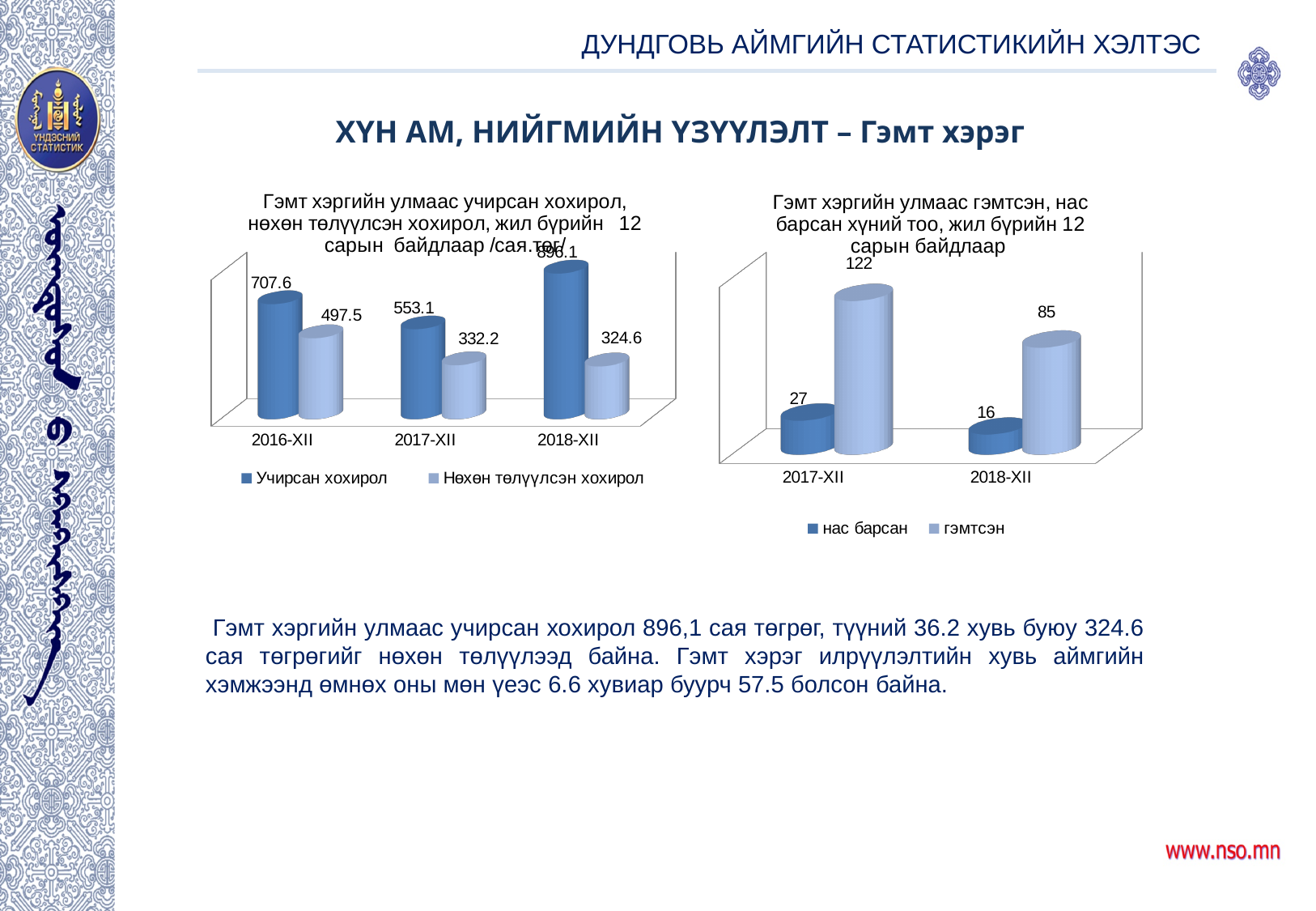
On the left chart, what is the value of Нөхөн төлүүлсэн хохирол for 2017-XII? 332.2 On the left chart, how many year categories are shown on the x axis? 3 On the left chart, how many series does the legend list? 2 On the left chart, what is the difference between Учирсан хохирол and Нөхөн төлүүлсэн хохирол in 2016-XII? 210.1 On the right chart, does the value of нас барсан rise or fall from 2017-XII to 2018-XII? fall On the left chart, what is the value of Учирсан хохирол for 2016-XII? 707.6 On the right chart, what is the value of гэмтсэн for 2017-XII? 122 On the left chart, in which year is Учирсан хохирол the highest? 2018-XII On the right chart, what is the value of нас барсан for 2018-XII? 16 On the left chart, what is the value of Нөхөн төлүүлсэн хохирол for 2018-XII? 324.6 On the right chart, what is the difference in гэмтсэн between 2017-XII and 2018-XII? 37 What type of chart is the right chart? bar chart